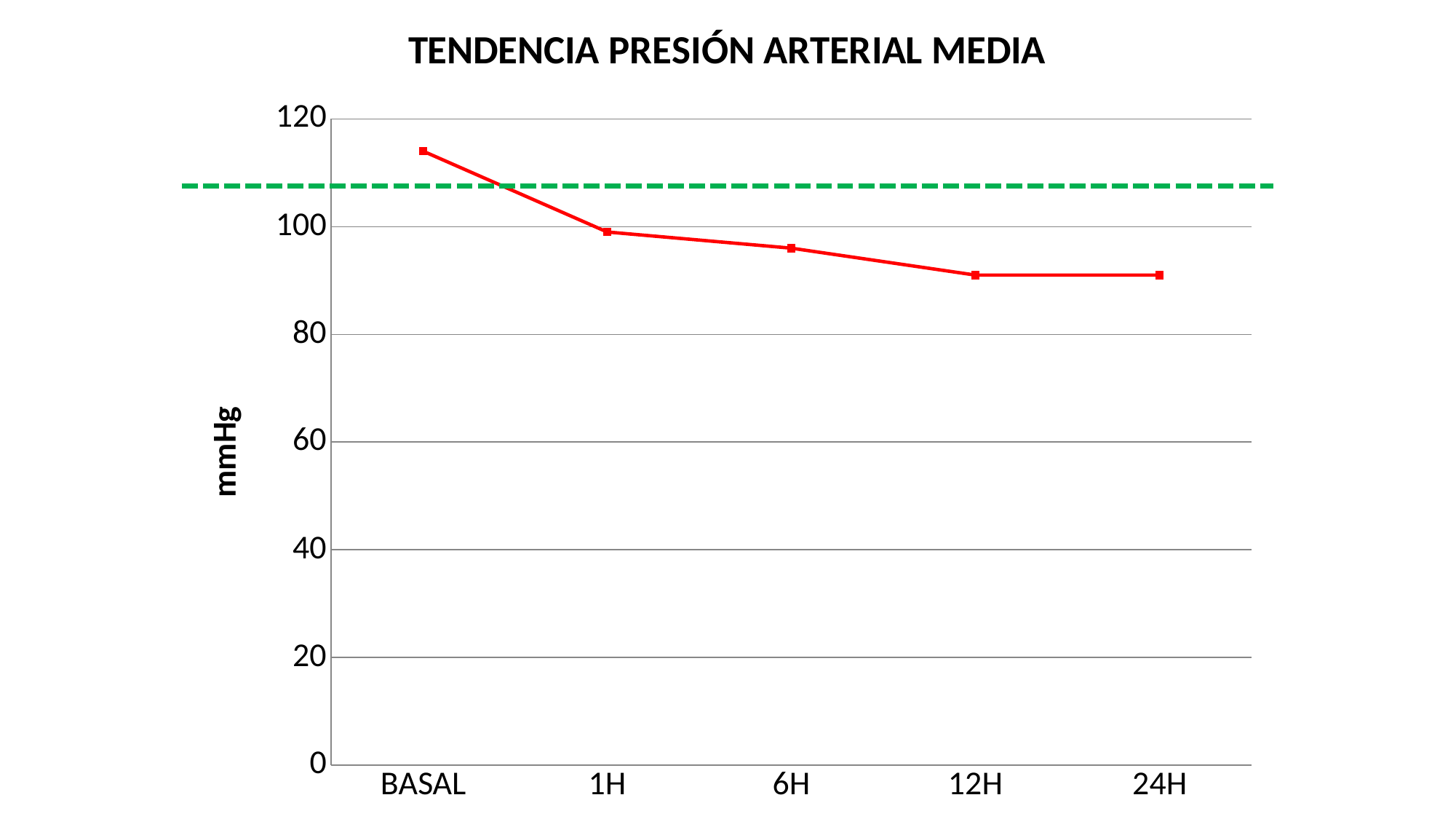
Is the value for 6H greater or less than 100? less Is the value for 12H greater or less than 80? greater Which is larger, the value for 1H or the value for 12H? 1H What kind of chart is shown on the slide? line chart Is the value for BASAL greater or less than 120? less How many time points are plotted on the x axis? 5 What is the title of the chart? TENDENCIA PRESIÓN ARTERIAL MEDIA Do the values rise or fall from BASAL to 24H? fall Which is larger, the value for BASAL or the value for 1H? BASAL Which time point has the highest value? BASAL What unit is shown on the y-axis label? mmHg